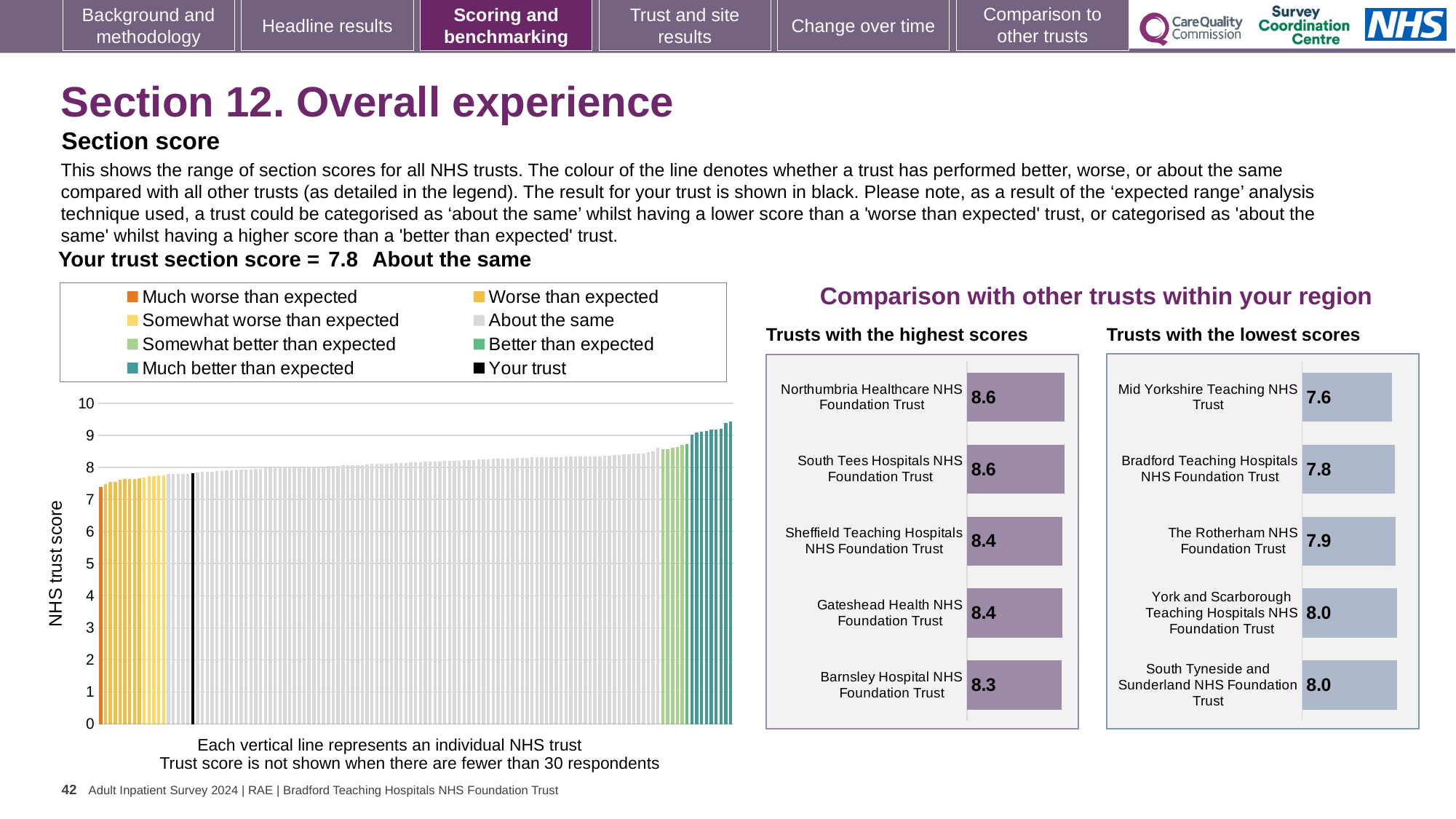
What kind of chart is the main 'NHS trust score' chart on the left? Bar chart In the 'Trusts with the lowest scores' chart, which trust has the lowest score? Mid Yorkshire Teaching NHS Trust In the 'Trusts with the lowest scores' chart, how much higher is Bradford Teaching Hospitals NHS Foundation Trust's score than Mid Yorkshire Teaching NHS Trust's? 0.2 In the 'Trusts with the highest scores' chart, which has the higher score: Sheffield Teaching Hospitals NHS Foundation Trust or Barnsley Hospital NHS Foundation Trust? Sheffield Teaching Hospitals NHS Foundation Trust In the 'Trusts with the highest scores' chart, which trust has the lowest score? Barnsley Hospital NHS Foundation Trust In the 'Trusts with the lowest scores' chart, what is the score for The Rotherham NHS Foundation Trust? 7.9 In the main 'NHS trust score' chart on the left, what is your trust's section score? 7.8 How many trusts are shown in the 'Trusts with the highest scores' chart? 5 How many entries does the legend of the main 'NHS trust score' chart on the left list? 8 How many trusts are shown in the 'Trusts with the lowest scores' chart? 5 In the 'Trusts with the highest scores' chart, what is the difference between the scores of Northumbria Healthcare NHS Foundation Trust and Barnsley Hospital NHS Foundation Trust? 0.3 In the 'Trusts with the highest scores' chart, what is the score for Barnsley Hospital NHS Foundation Trust? 8.3